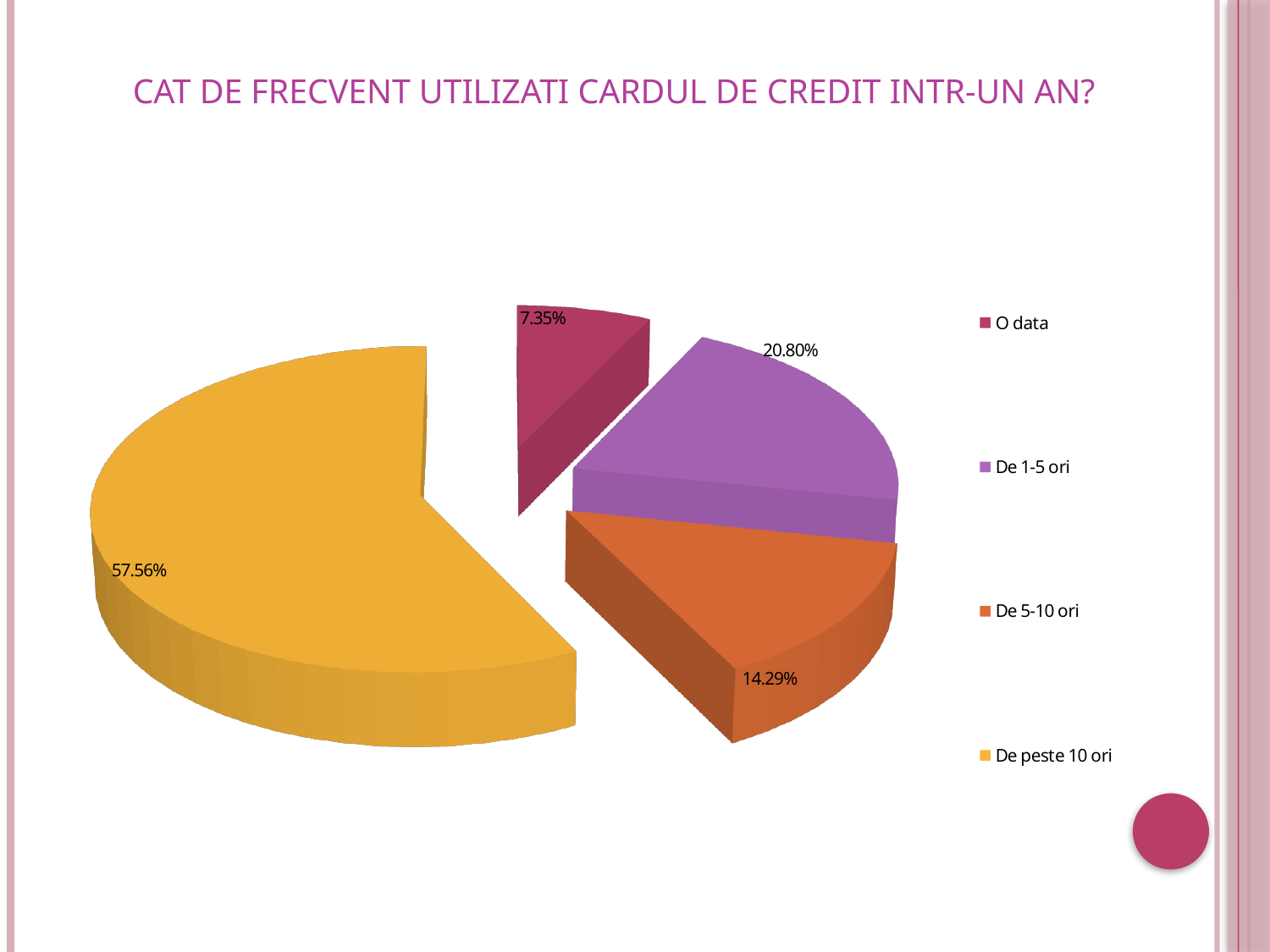
What percentage is shown for the "O data" slice? 7.35% Which slice is larger, "De 5-10 ori" or "O data"? De 5-10 ori What percentage is shown for the "De 5-10 ori" slice? 14.29% What kind of chart is shown on the slide? Pie chart What colour is the "De 1-5 ori" slice in the pie chart? Purple What percentage is shown for the "De 1-5 ori" slice? 20.80% What is the difference in percentage points between "De 1-5 ori" and "De 5-10 ori"? 6.51 How many categories does the pie chart show? 4 What is the title of the chart on the slide? CAT DE FRECVENT UTILIZATI CARDUL DE CREDIT INTR-UN AN? What percentage of the pie is labelled for "De peste 10 ori"? 57.56% Which category has the largest slice of the pie? De peste 10 ori Which category has the smallest slice of the pie? O data